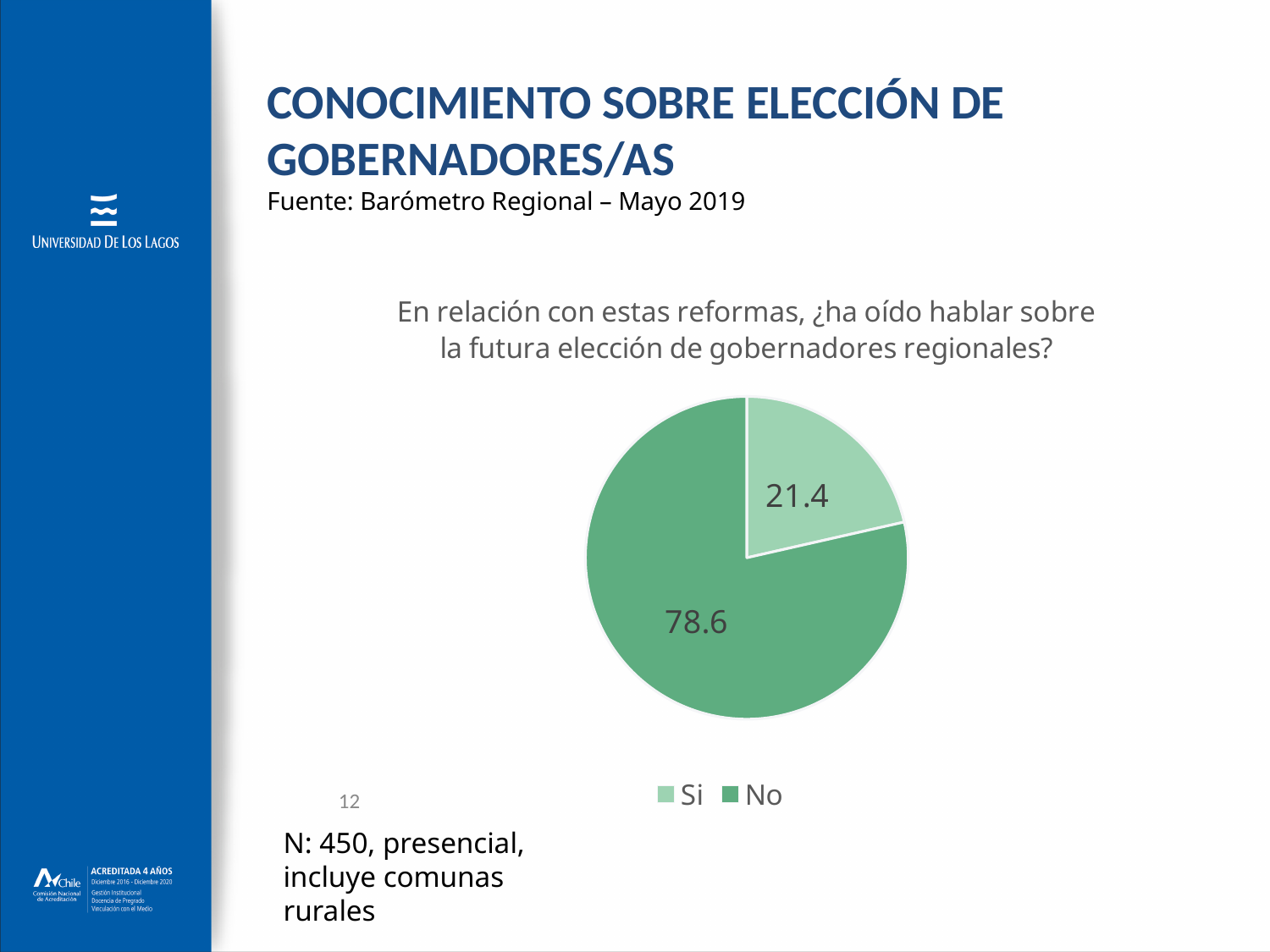
What is the total of the two values shown in the pie chart? 100 How many entries does the legend list? 2 Which legend entry is shown in the darker green colour? No What question is the pie chart answering, as shown above it? En relación con estas reformas, ¿ha oído hablar sobre la futura elección de gobernadores regionales? Which is larger, the value for "Si" or the value for "No"? No How many slices does the pie chart have? 2 Which category has the smallest slice in the pie chart? Si What is the value for "Si" in the pie chart? 21.4 What is the value for "No" in the pie chart? 78.6 Which category has the largest slice in the pie chart? No What kind of chart is shown on the slide? pie chart What is the difference between the values for "No" and "Si"? 57.2